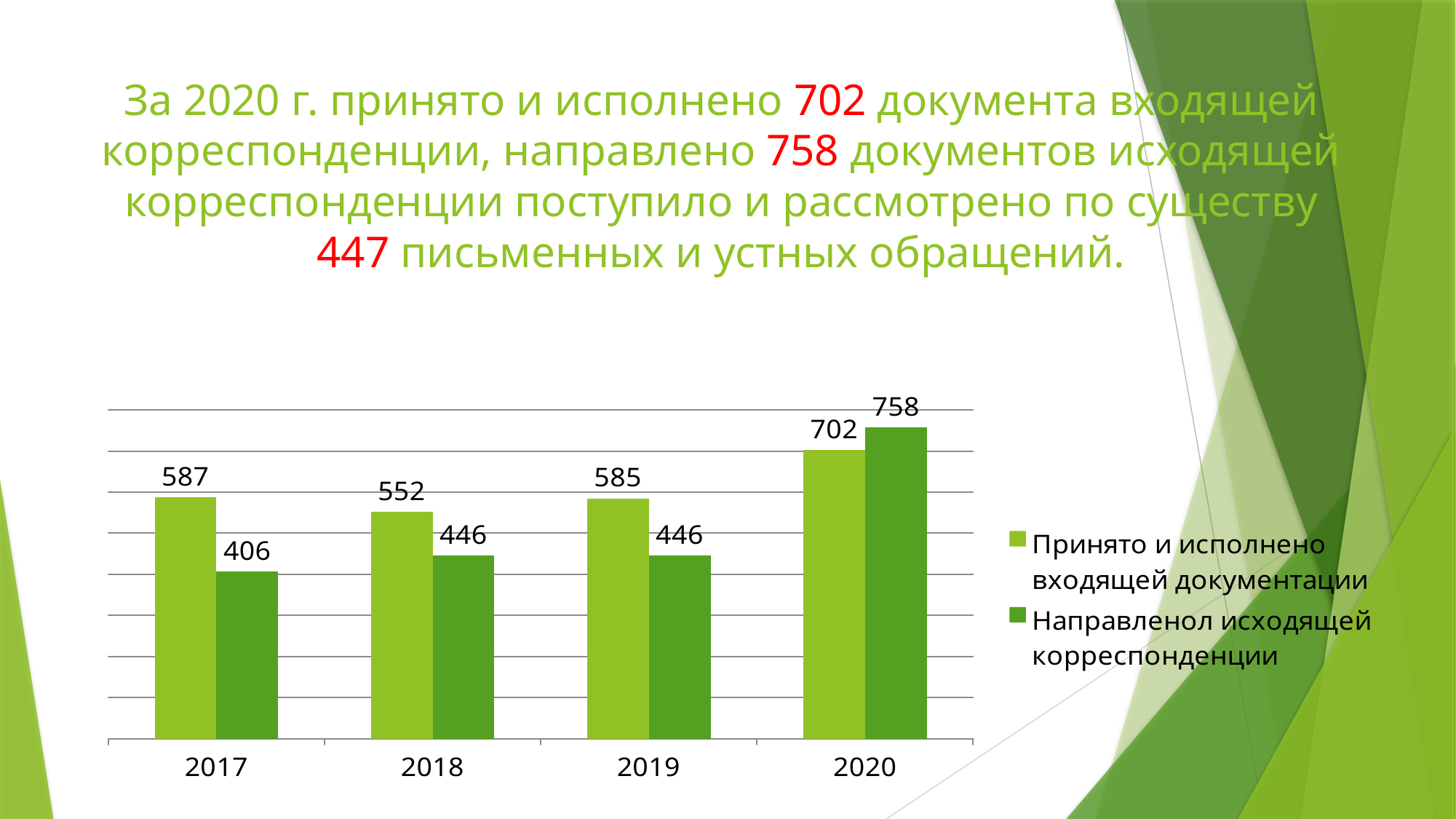
In which year is 'Принято и исполнено входящей документации' lowest? 2018 What is the value for 'Направленол исходящей корреспонденции' in 2018? 446 In 2020, which series has the larger value? Направленол исходящей корреспонденции In which year is 'Направленол исходящей корреспонденции' lowest? 2017 What is the value for 'Принято и исполнено входящей документации' in 2017? 587 In which year is 'Направленол исходящей корреспонденции' highest? 2020 Does 'Направленол исходящей корреспонденции' rise or fall from 2017 to 2020? rise What is the value for 'Принято и исполнено входящей документации' in 2020? 702 How many series does the legend list? 2 What type of chart is shown on the slide? bar chart How many years are shown on the x axis? 4 What is the difference between the two series in 2017? 181